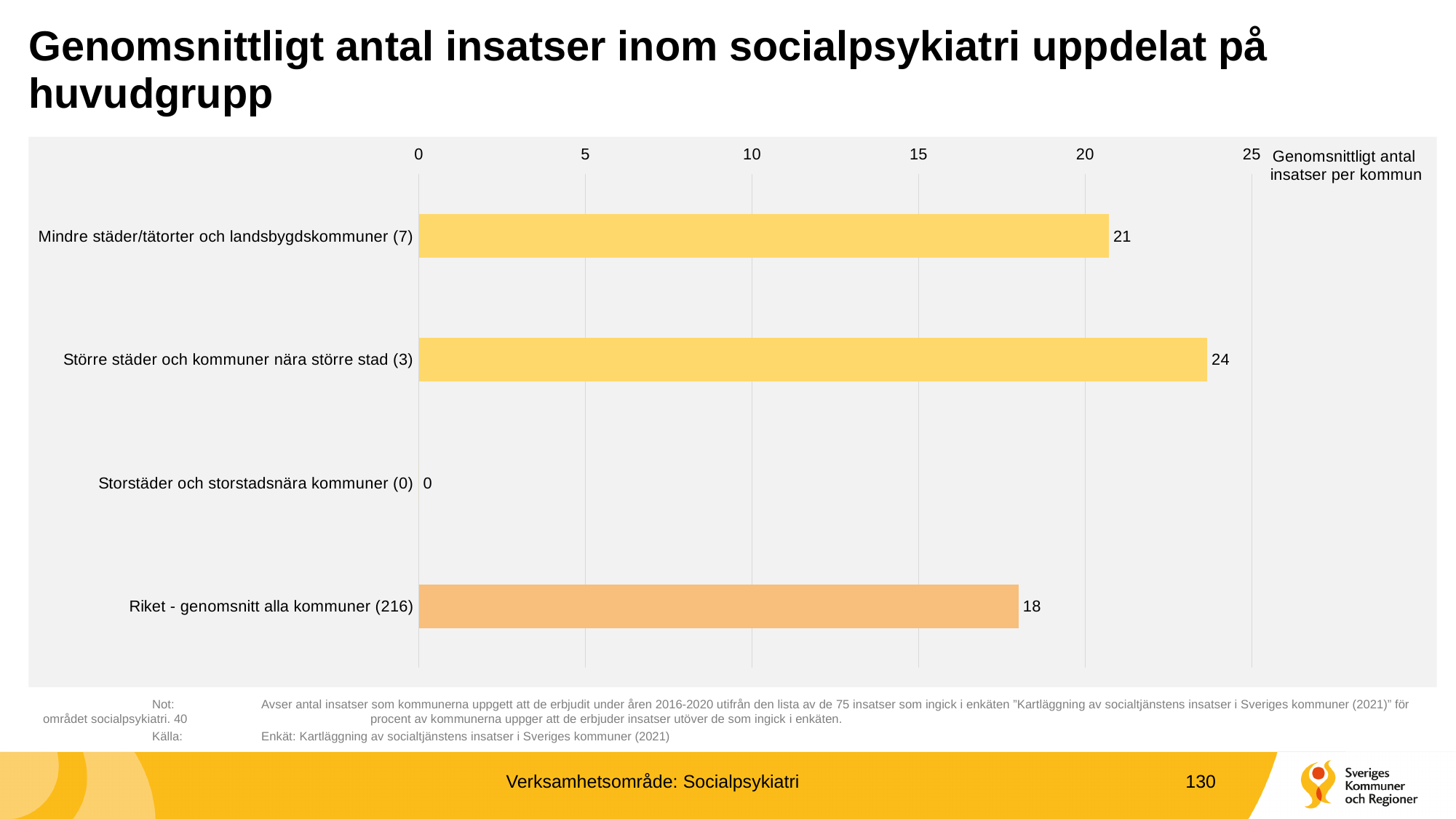
What kind of chart is shown on the slide? Bar chart What is the value for Storstäder och storstadsnära kommuner (0)? 0 What is the value for Mindre städer/tätorter och landsbygdskommuner (7)? 21 What is the label of the value axis at the top of the chart? Genomsnittligt antal insatser per kommun Which category has the highest value? Större städer och kommuner nära större stad (3) Is the value for Mindre städer/tätorter och landsbygdskommuner (7) greater or less than 20? greater What is the difference between the values for Större städer och kommuner nära större stad (3) and Riket - genomsnitt alla kommuner (216)? 6 Which category has the lowest value? Storstäder och storstadsnära kommuner (0) Which is larger: the value for Mindre städer/tätorter och landsbygdskommuner (7) or for Riket - genomsnitt alla kommuner (216)? Mindre städer/tätorter och landsbygdskommuner (7) What is the value for Större städer och kommuner nära större stad (3)? 24 How many categories are shown in the chart? 4 What is the value for Riket - genomsnitt alla kommuner (216)? 18